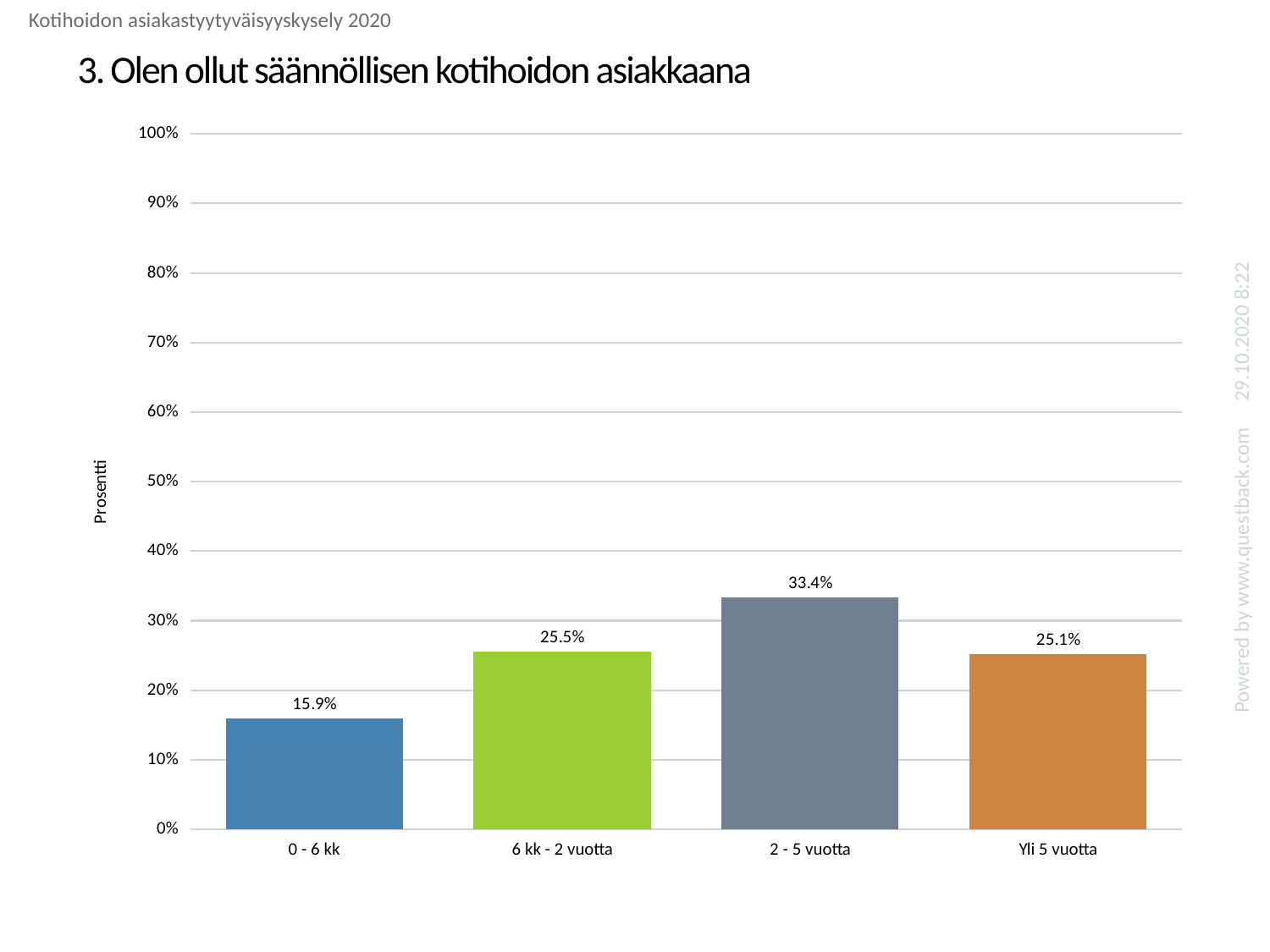
What is the value for the '2 - 5 vuotta' category? 33.4% How many categories are shown on the x axis? 4 Which category has the highest value? 2 - 5 vuotta What is the value for the 'Yli 5 vuotta' category? 25.1% What is the value for the '6 kk - 2 vuotta' category? 25.5% What is the label of the y axis? Prosentti Which is larger, the value for '2 - 5 vuotta' or the value for 'Yli 5 vuotta'? 2 - 5 vuotta What is the difference between the values for '2 - 5 vuotta' and '0 - 6 kk'? 17.5% What is the value for the '0 - 6 kk' category? 15.9% Which category has the lowest value? 0 - 6 kk What kind of chart is shown on the slide? bar chart Is the value for '2 - 5 vuotta' greater or less than 30%? greater